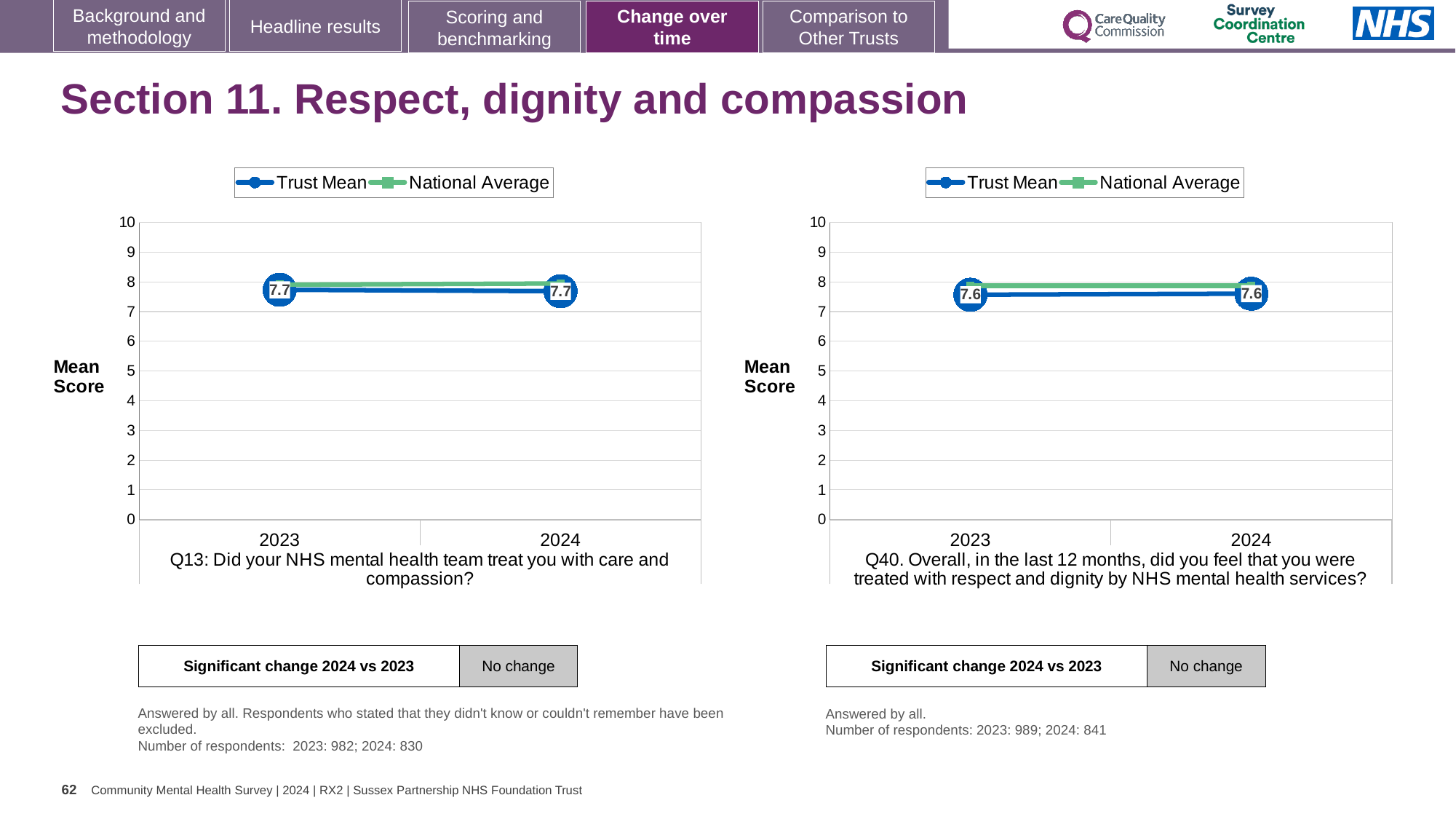
What are the two legend entries shown for the left chart (Q13)? Trust Mean and National Average In the right chart (Q40), what is the Trust Mean score for 2023? 7.6 How many series does the legend of the right chart (Q40) list? 2 In the right chart (Q40), what is the Trust Mean score for 2024? 7.6 What kind of chart is the left chart (Q13)? Line chart In the left chart (Q13), what is the Trust Mean score for 2023? 7.7 How many years are plotted on the x axis of the left chart (Q13)? 2 In the left chart (Q13), what is the Trust Mean score for 2024? 7.7 In the left chart (Q13), does the Trust Mean rise, fall or stay the same from 2023 to 2024? Stays the same In the right chart (Q40), is the National Average value for 2024 greater or less than 7? greater In the left chart (Q13), is the National Average value for 2023 greater or less than 9? less In the right chart (Q40), what is the difference between the Trust Mean in 2024 and in 2023? 0